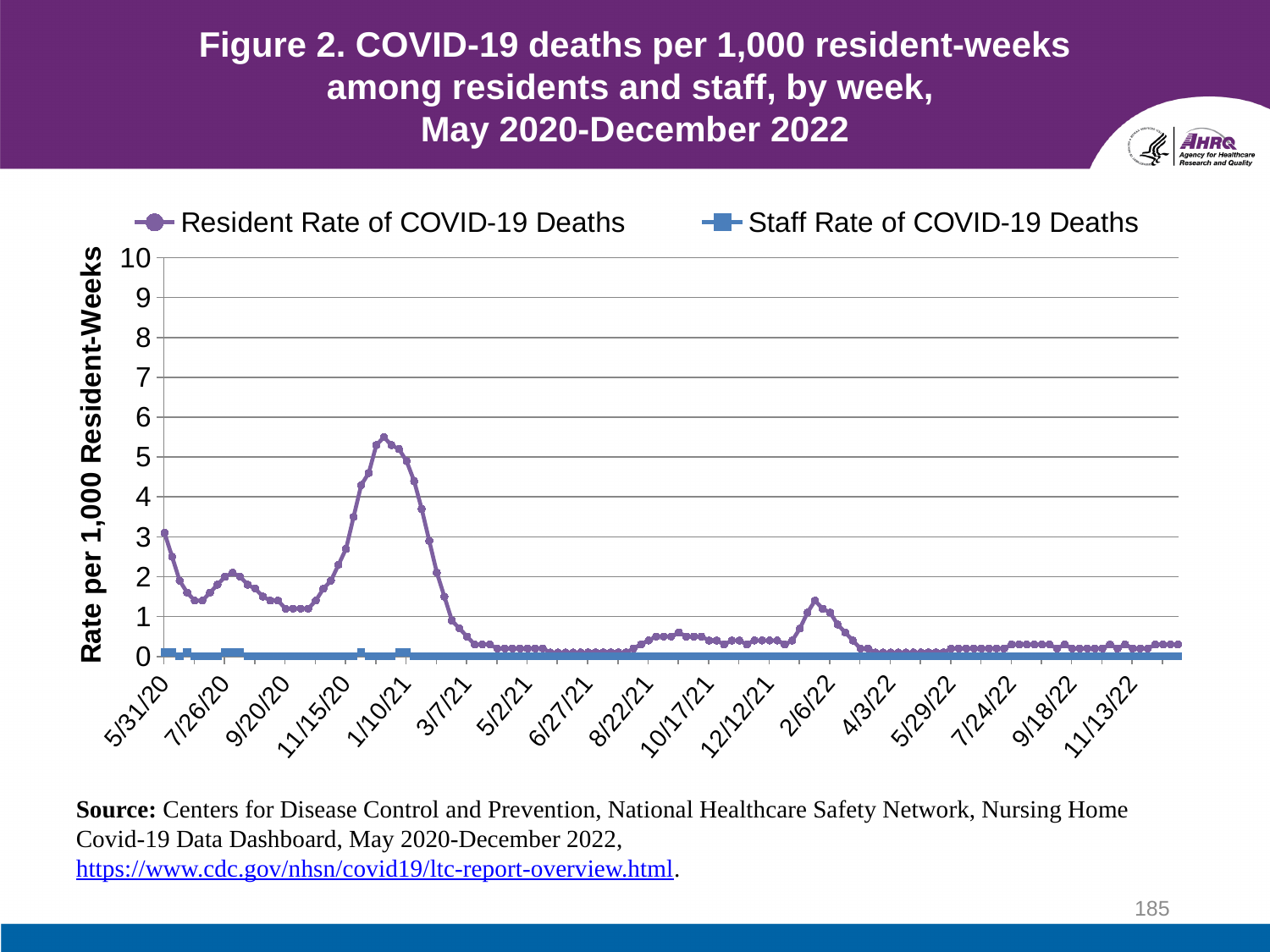
Is the Staff Rate of COVID-19 Deaths ever greater than 1 at any point on the chart? No What is the title of the y-axis? Rate per 1,000 Resident-Weeks Is the Resident Rate of COVID-19 Deaths at 5/31/20 greater or less than 2? greater How many series does the legend list? 2 Is the Resident Rate of COVID-19 Deaths at 5/2/21 greater or less than 1? less Which series reaches the higher values, Resident Rate of COVID-19 Deaths or Staff Rate of COVID-19 Deaths? Resident Rate of COVID-19 Deaths Around which x-axis date does the Resident Rate of COVID-19 Deaths reach its highest peak? 1/10/21 What kind of chart is shown on the slide? line chart Does the Resident Rate of COVID-19 Deaths rise or fall between 1/10/21 and 3/7/21? fall What colour is the line for the Staff Rate of COVID-19 Deaths? blue Does the Resident Rate of COVID-19 Deaths rise or fall between 9/20/20 and 1/10/21? rise